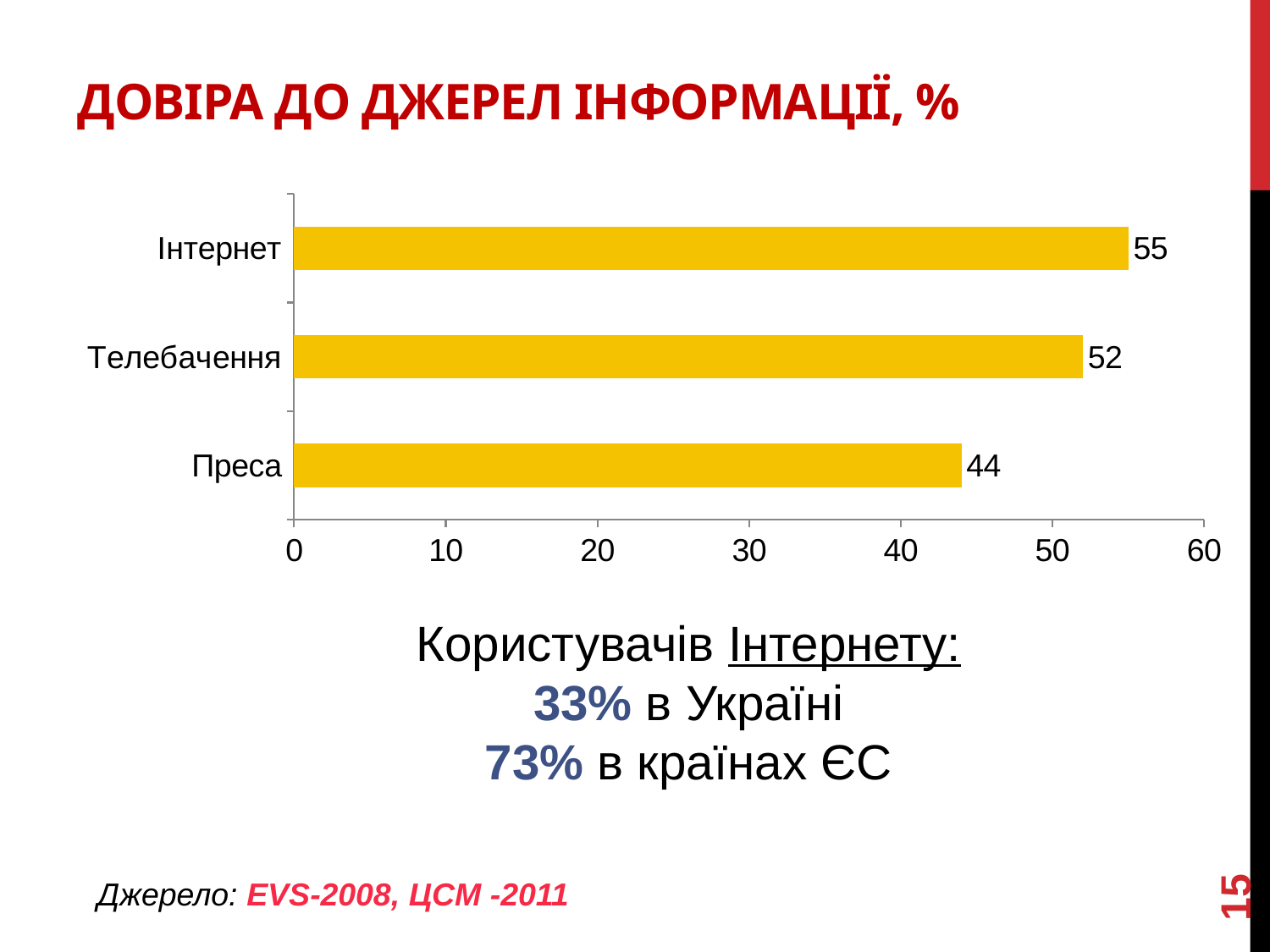
Which is larger, the value for Інтернет or the value for Преса? Інтернет Which category has the lowest value? Преса Is the value for Преса greater or less than 50? less How many categories are shown in the chart? 3 What is the value for Інтернет? 55 Which category has the highest value? Інтернет What is the title of the chart on the slide? ДОВІРА ДО ДЖЕРЕЛ ІНФОРМАЦІЇ, % What is the value for Преса? 44 What kind of chart is shown on the slide? bar chart What is the difference between the values for Телебачення and Преса? 8 What is the difference between the values for Інтернет and Преса? 11 What is the value for Телебачення? 52